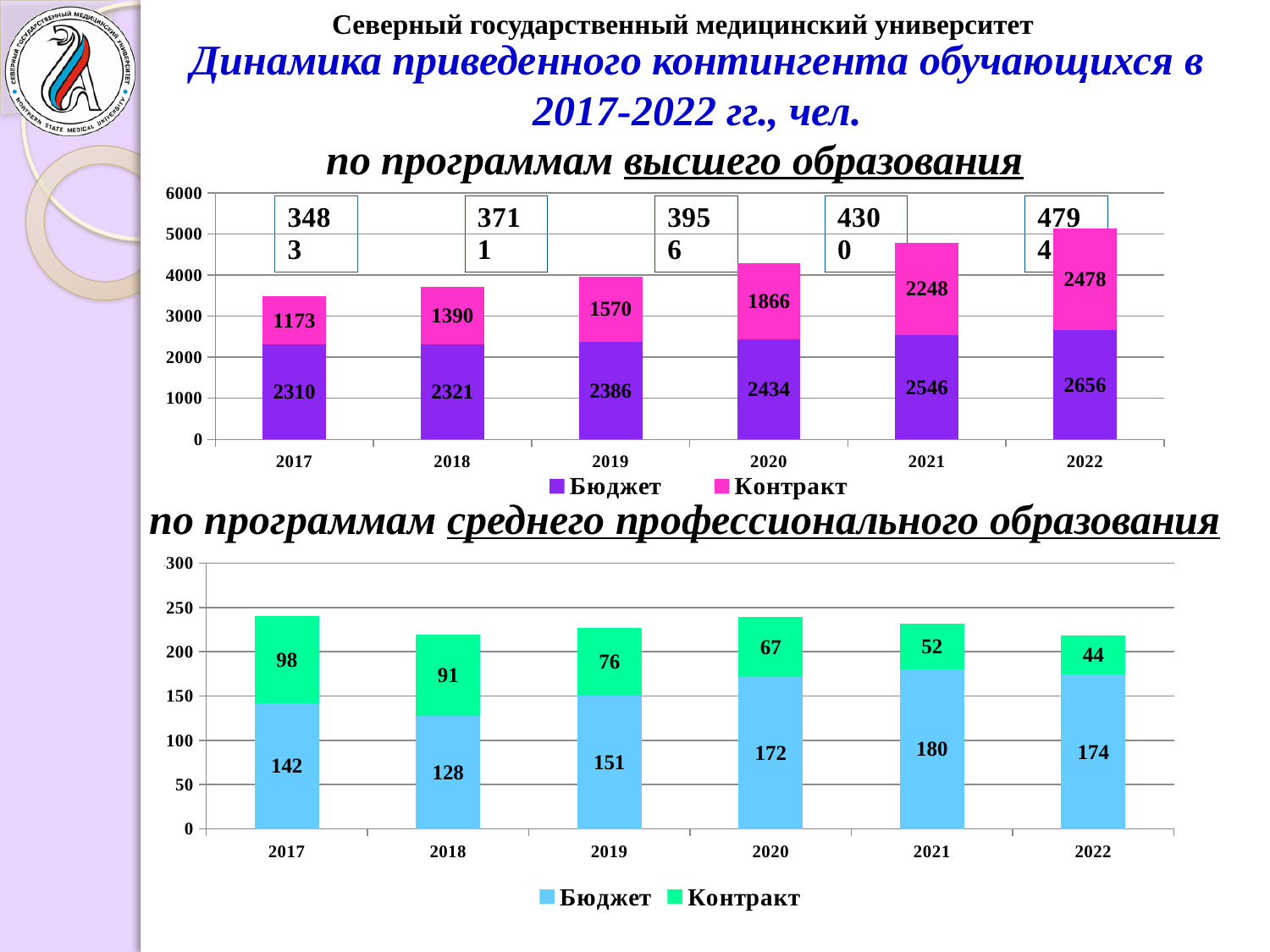
In the secondary vocational education chart (bottom), what is the Контракт value for 2018? 91 In the higher education chart (top), what is the Бюджет value for 2019? 2386 How many series does the legend of the secondary vocational education chart (bottom) list? 2 In the secondary vocational education chart (bottom), is the Бюджет value for 2020 larger than the Бюджет value for 2019? Yes In the higher education chart (top), which year has the highest Контракт value? 2022 In the secondary vocational education chart (bottom), which year has the lowest Контракт value? 2022 In the higher education chart (top), does the Контракт value rise or fall from 2017 to 2022? rise In the secondary vocational education chart (bottom), which year has the highest Бюджет value? 2021 In the higher education chart (top), what is the difference between the Бюджет values for 2022 and 2017? 346 In the higher education chart (top), what is the Контракт value for 2021? 2248 In the higher education chart (top), what is the total of the stacked bar for 2020? 4300 In the secondary vocational education chart (bottom), what is the total of the stacked bar for 2017? 240